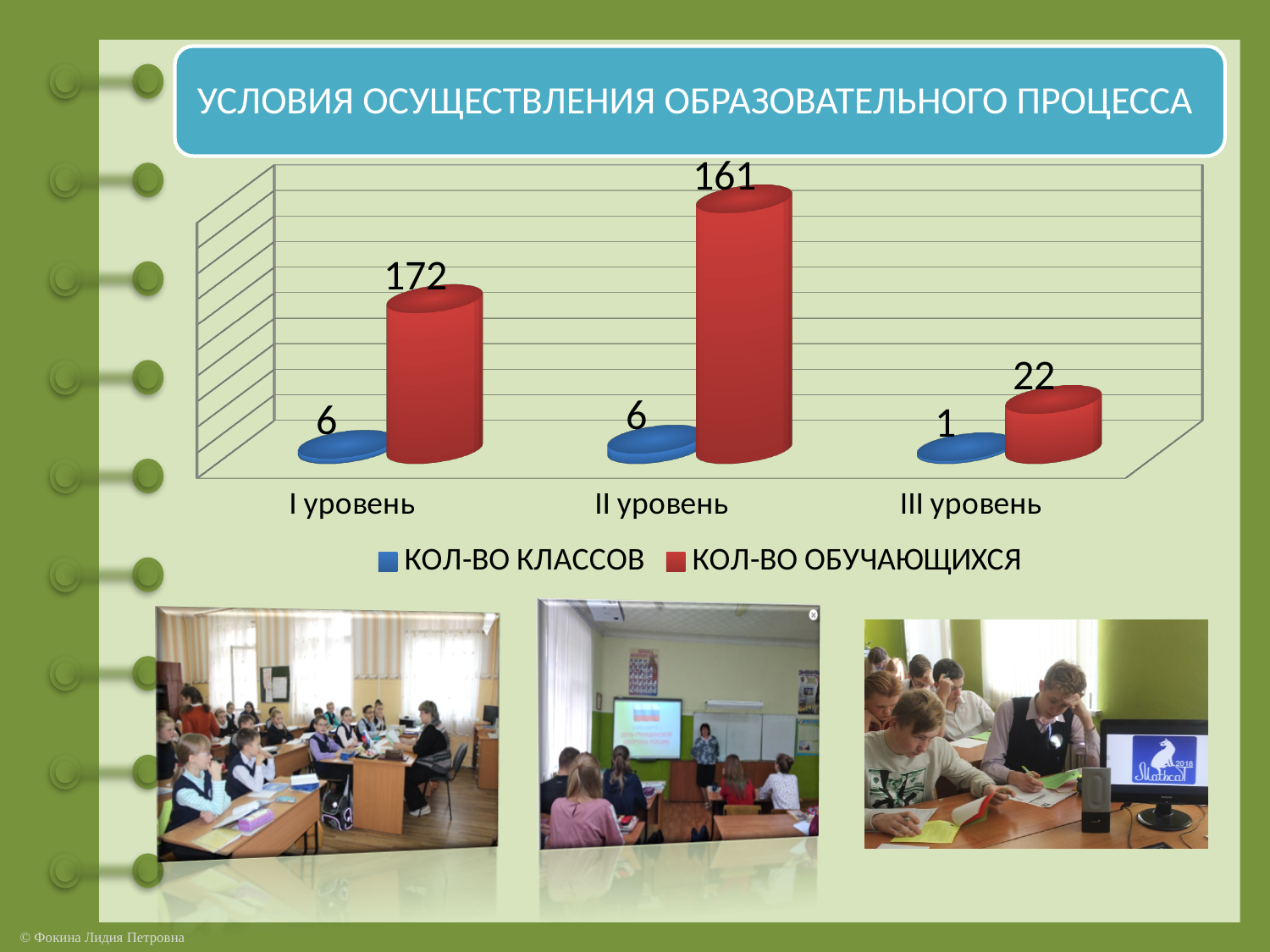
How many categories are shown on the x axis of the chart? 3 What is the value of КОЛ-ВО КЛАССОВ for I уровень? 6 What is the value of КОЛ-ВО ОБУЧАЮЩИХСЯ for III уровень? 22 How many series does the chart legend list? 2 What is the value of КОЛ-ВО ОБУЧАЮЩИХСЯ for I уровень? 172 Which category has the lowest value of КОЛ-ВО ОБУЧАЮЩИХСЯ? III уровень Which category has the lowest value of КОЛ-ВО КЛАССОВ? III уровень What is the value of КОЛ-ВО ОБУЧАЮЩИХСЯ for II уровень? 161 What is the value of КОЛ-ВО КЛАССОВ for III уровень? 1 What is the difference between КОЛ-ВО ОБУЧАЮЩИХСЯ for II уровень and III уровень? 139 What kind of chart is shown on the slide? Bar chart Is КОЛ-ВО ОБУЧАЮЩИХСЯ larger for II уровень or for III уровень? II уровень